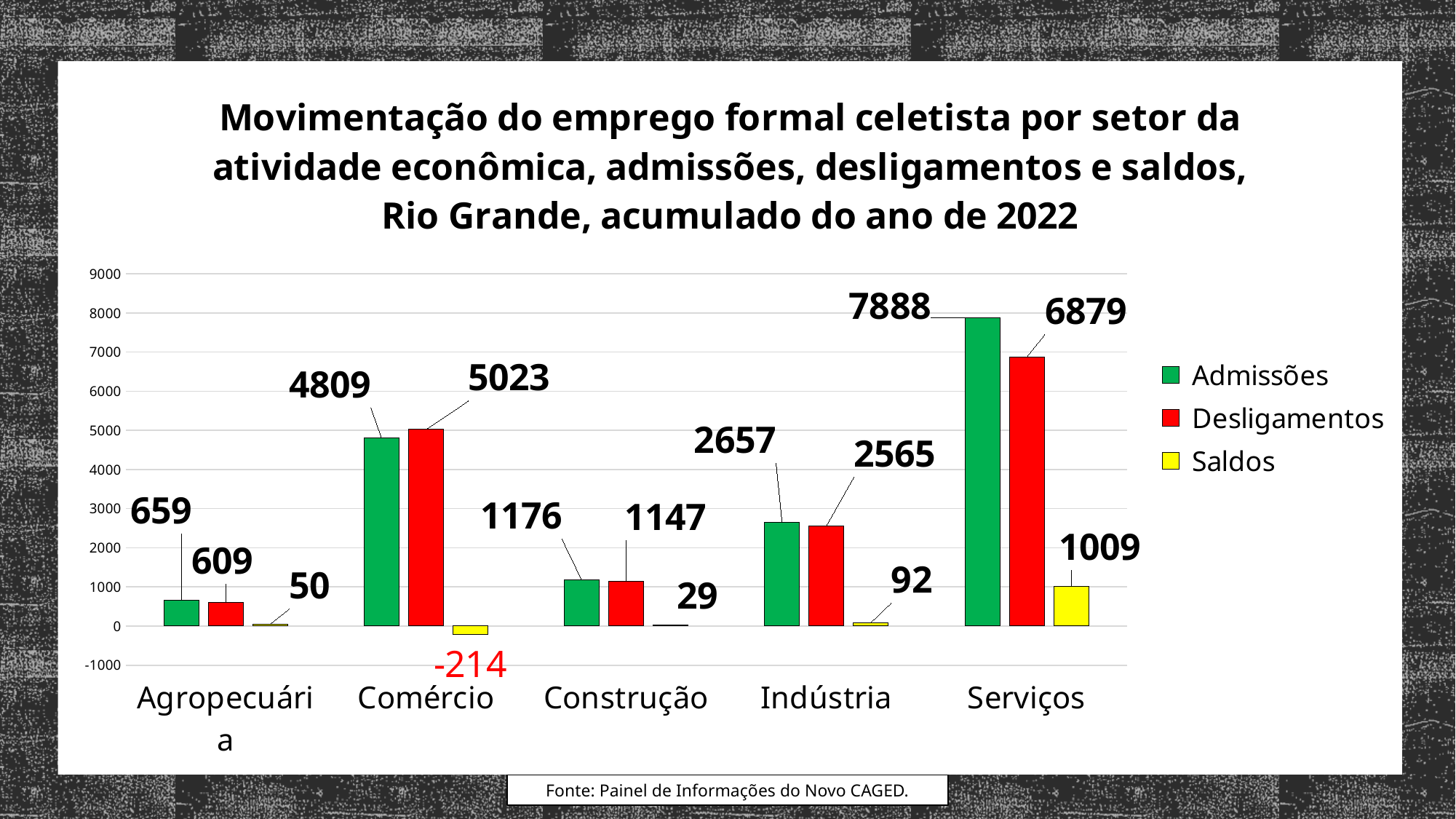
How many series does the legend list? 3 Which sector has the lowest Desligamentos value? Agropecuária What is the Saldos value for Construção? 29 What is the Admissões value for Serviços? 7888 Which is larger for Comércio, Admissões or Desligamentos? Desligamentos Is the Admissões value for Indústria greater or less than 3000? less How many sectors are shown on the x axis? 5 Which sector has the highest Admissões value? Serviços What is the Desligamentos value for Comércio? 5023 What is the Saldos value for Comércio? -214 What kind of chart is shown on the slide? bar chart What is the difference between Admissões and Desligamentos for Indústria? 92